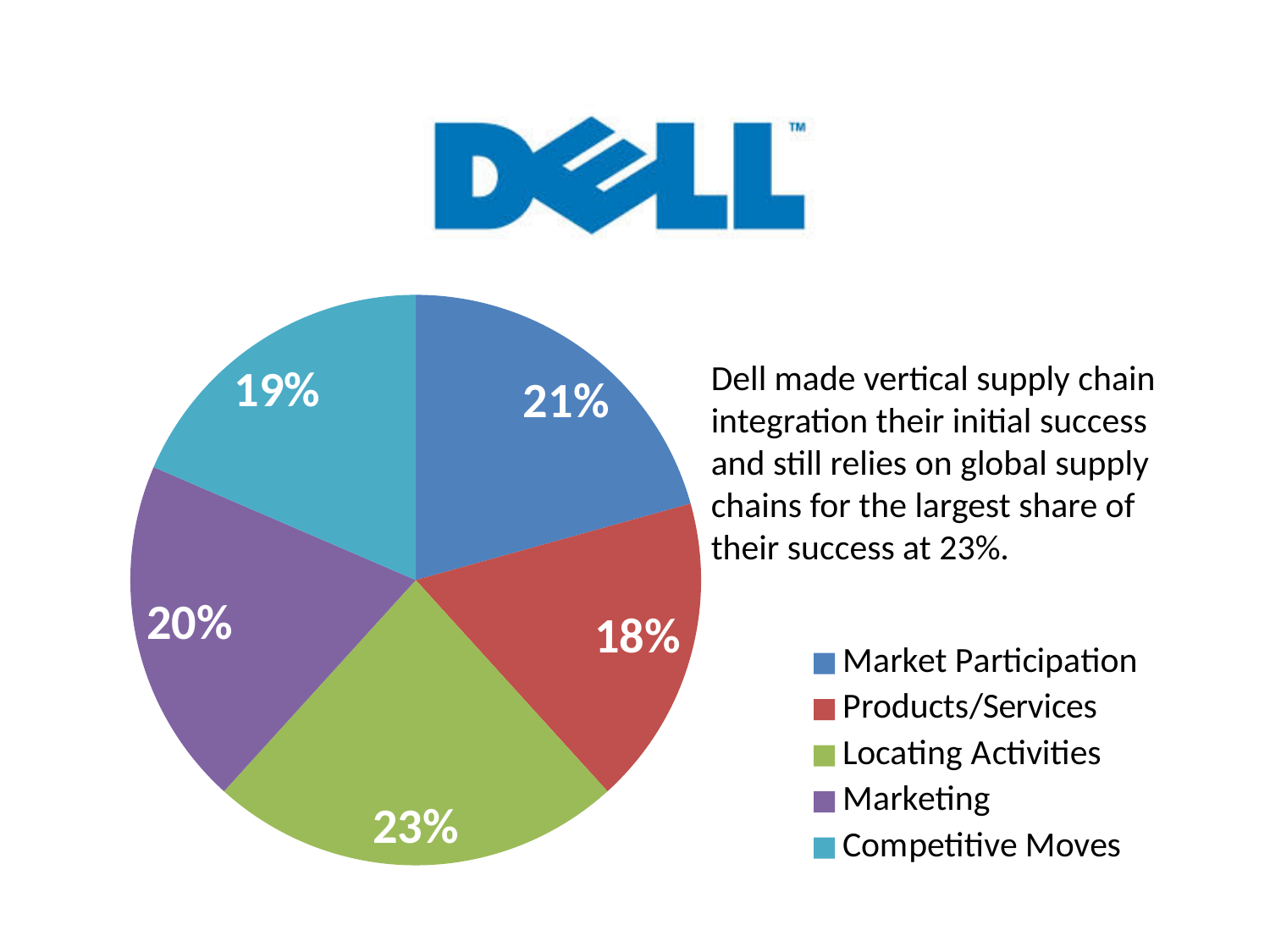
What is the difference in percentage points between Locating Activities and Products/Services? 5 What colour is the Marketing slice? purple What share of the pie does Locating Activities have? 23% What share of the pie does Competitive Moves have? 19% Which is larger, the share for Market Participation or the share for Competitive Moves? Market Participation How many slices does the pie chart have? 5 Which category has the smallest slice of the pie? Products/Services What share of the pie does Products/Services have? 18% What kind of chart is shown on the slide? pie chart Which category has the largest slice of the pie? Locating Activities What share of the pie does Marketing have? 20% What share of the pie does Market Participation have? 21%